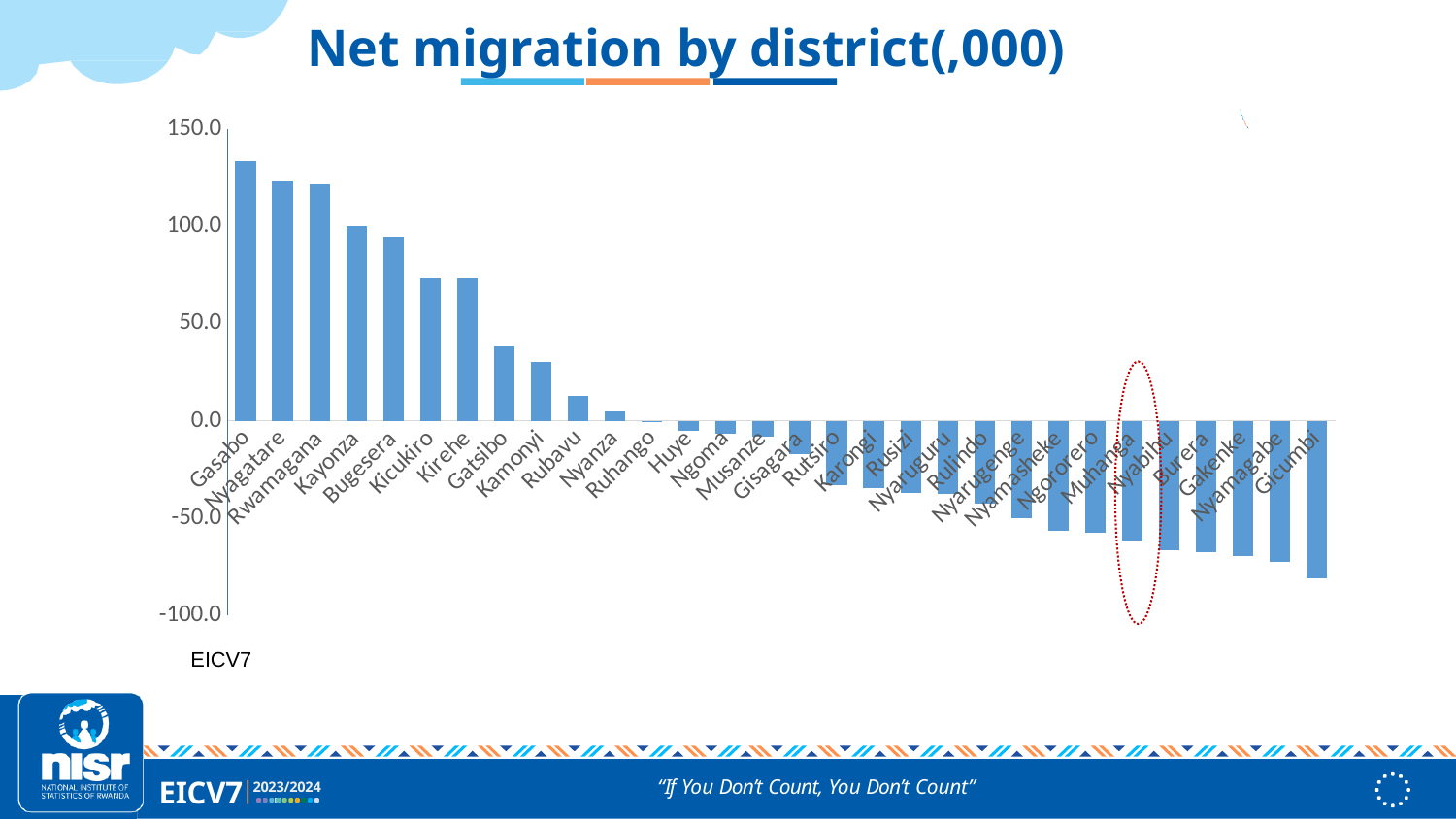
Is the value for Bugesera greater or less than 100.0? less Do the values rise or fall moving from left to right along the x axis? fall Is the value for Kicukiro greater or less than 50.0? greater Which district has the highest net migration? Gasabo Is the value for Gasabo greater or less than 100.0? greater Which has the larger net migration, Gasabo or Nyagatare? Gasabo Which district has the lowest net migration? Gicumbi What kind of chart is shown on the slide? bar chart What is the title of the chart? Net migration by district(,000) How many districts are plotted in the chart? 30